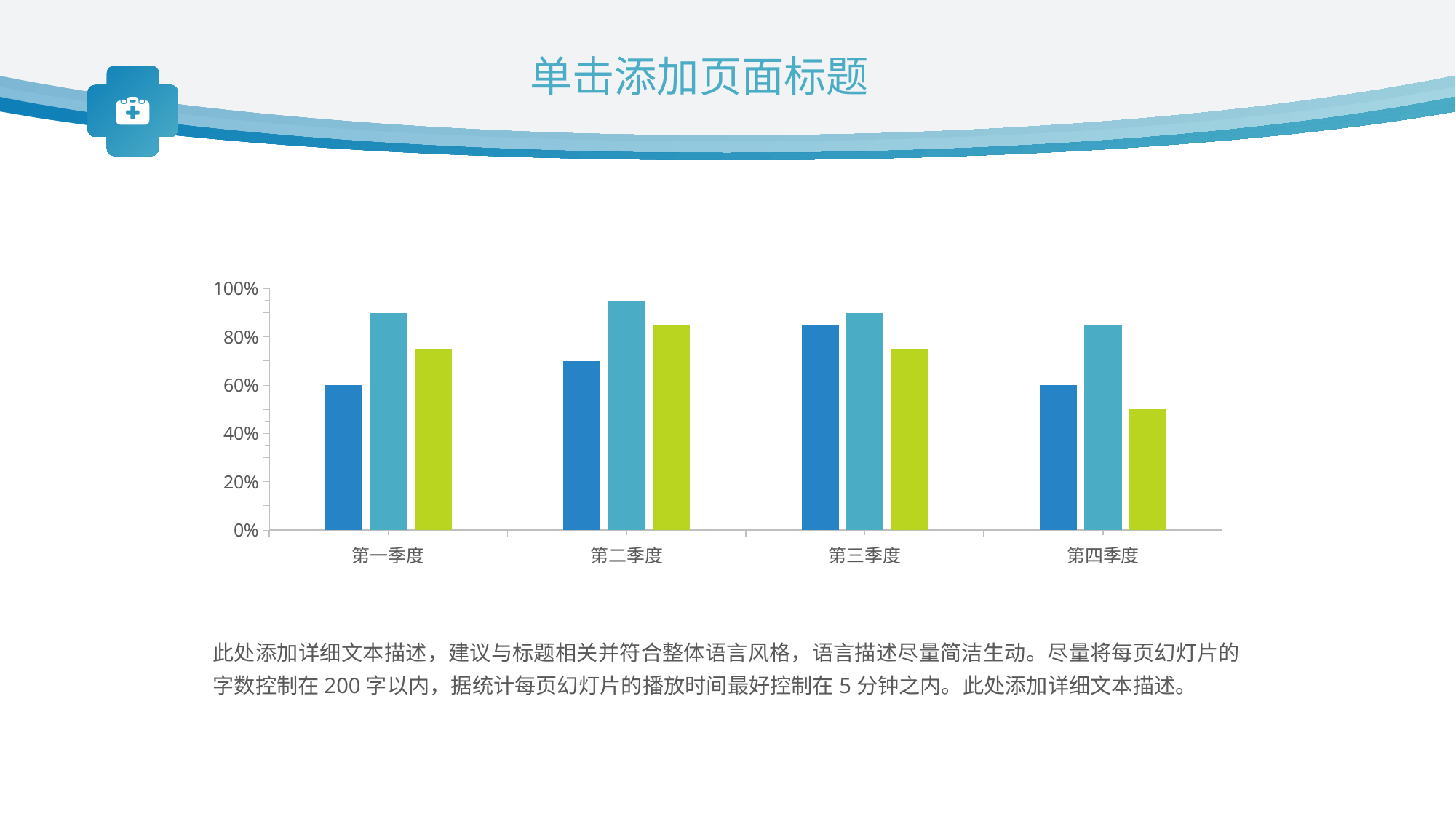
Is the value of the dark blue bar for 第三季度 greater or less than 80%? greater How many bars are plotted for each quarter in the chart? 3 Is the value of the green bar for 第一季度 greater or less than 80%? less What is the value of the dark blue bar for 第一季度? 60% Is the value of the teal bar for 第二季度 greater or less than 80%? greater For 第一季度, which bar is taller, the dark blue bar or the teal bar? the teal bar What is the value of the dark blue bar for 第四季度? 60% Which quarter has the tallest bar in the chart? 第二季度 What kind of chart is shown on the slide? bar chart How many categories are shown on the x axis of the chart? 4 Which quarter has the shortest bar in the chart? 第四季度